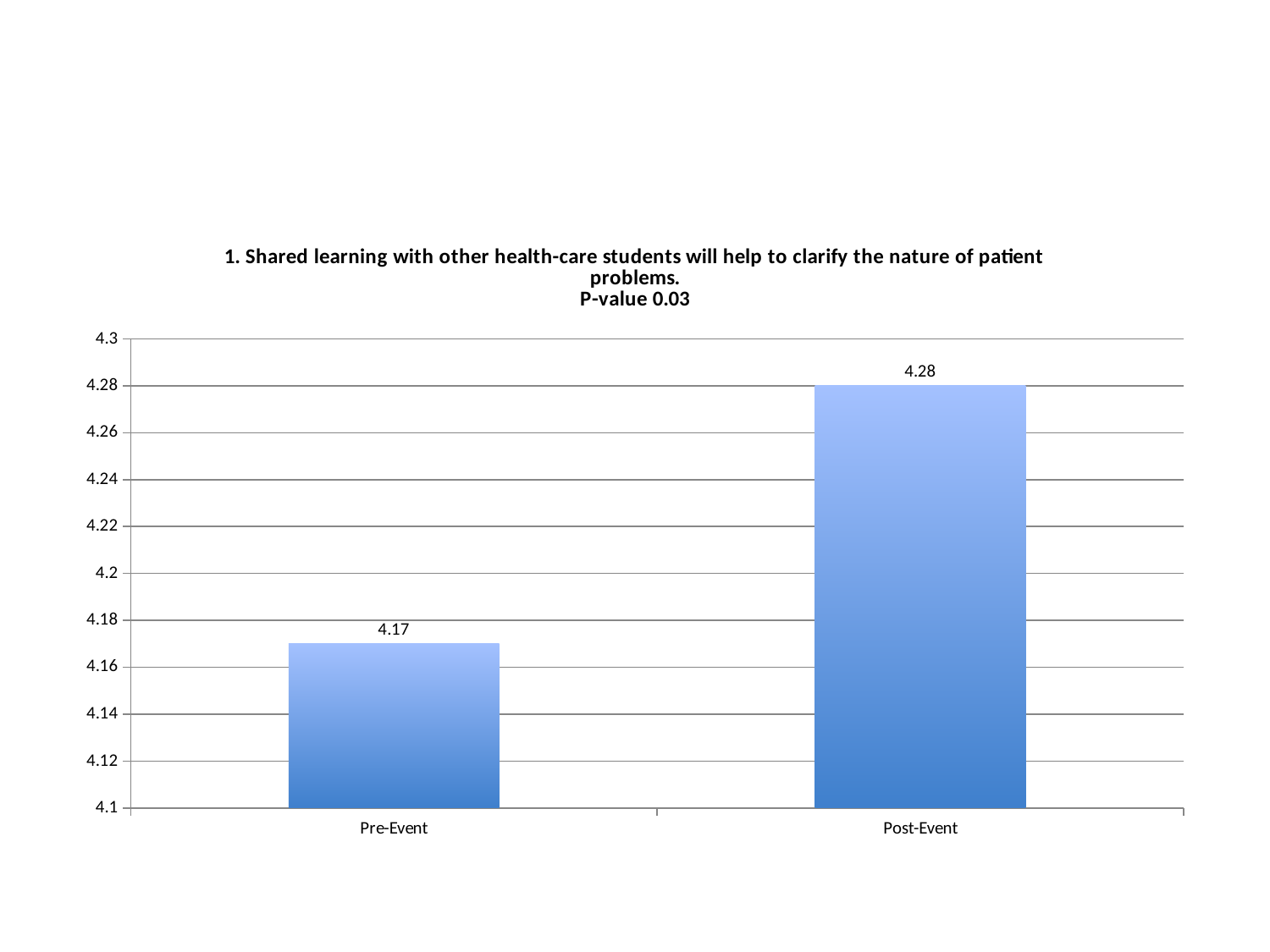
What kind of chart is shown on the slide? bar chart What P-value is stated in the chart title? 0.03 Which category has the lowest value? Pre-Event What is the difference between the Post-Event and Pre-Event values? 0.11 What is the value for Post-Event? 4.28 What is the value for Pre-Event? 4.17 Is the value for Post-Event greater or less than 4.2? greater Which category has the highest value? Post-Event Do the values rise or fall from Pre-Event to Post-Event? rise Is the value for Pre-Event greater or less than 4.2? less How many categories are shown on the x axis? 2 Which is larger, the Pre-Event value or the Post-Event value? Post-Event